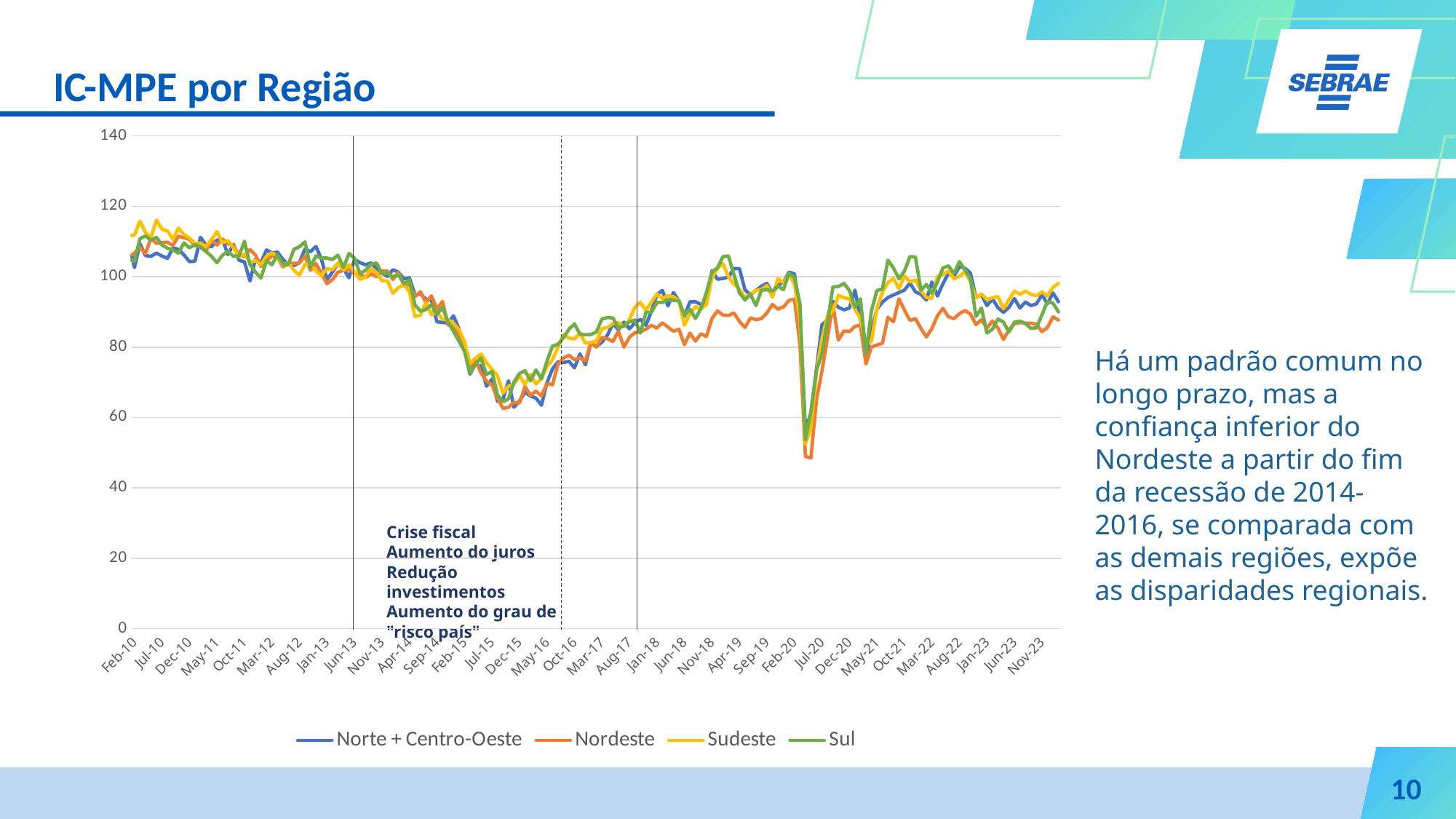
What is the title of the slide containing the chart? IC-MPE por Região Is the value for Sudeste at Feb-10 greater or less than 100? greater Is the value for Nordeste at Nov-23 greater or less than 100? less Which series in the chart is drawn in orange? Nordeste Do the values of the series rise or fall between Jun-13 and Jul-15? fall What kind of chart is shown on the slide? line chart Which series has the lowest value at Nov-23? Nordeste How many series does the legend of the chart list? 4 Is the value for Sul at Dec-15 greater or less than 80? less At Nov-23, which is larger: the value for Sudeste or the value for Nordeste? Sudeste Do the values of the series rise or fall between Jul-15 and Jan-18? rise